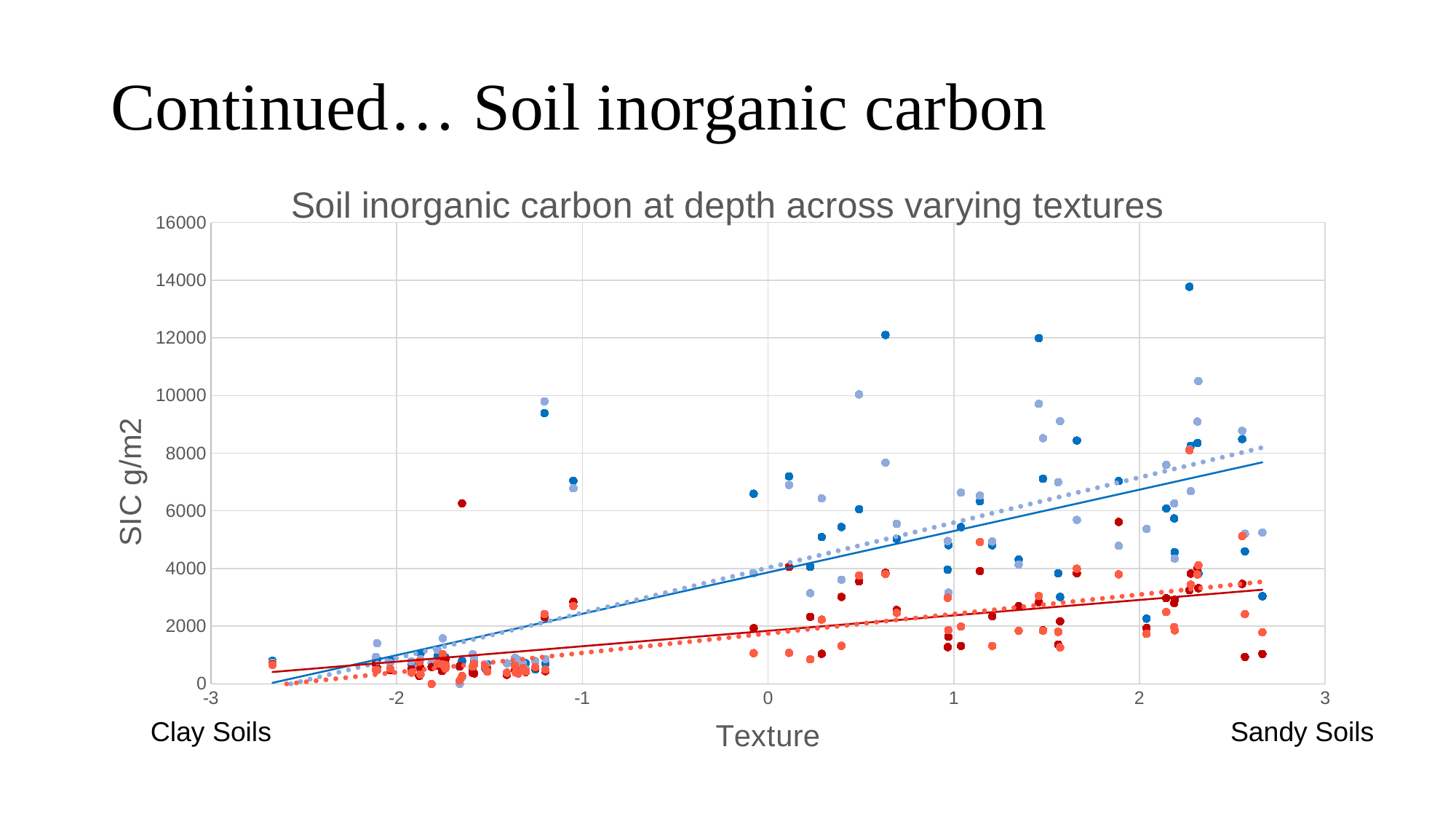
Are the red points near texture value 2.6 greater or less than 6000 SIC g/m2? less What kind of chart is shown on the slide? scatter chart Do the trend lines rise or fall as texture moves from clay soils to sandy soils? rise Is the highest plotted point on the chart greater or less than 14000 SIC g/m2? less What is the lowest value shown on the x axis? -3 What is the label of the y axis? SIC g/m2 What is the highest value shown on the y axis? 16000 Which end of the texture axis is labelled Sandy Soils, the left or the right? right Is the highest plotted point on the chart greater or less than 12000 SIC g/m2? greater What is the title of the chart? Soil inorganic carbon at depth across varying textures Which colour of points generally reaches higher SIC values, blue or red? blue